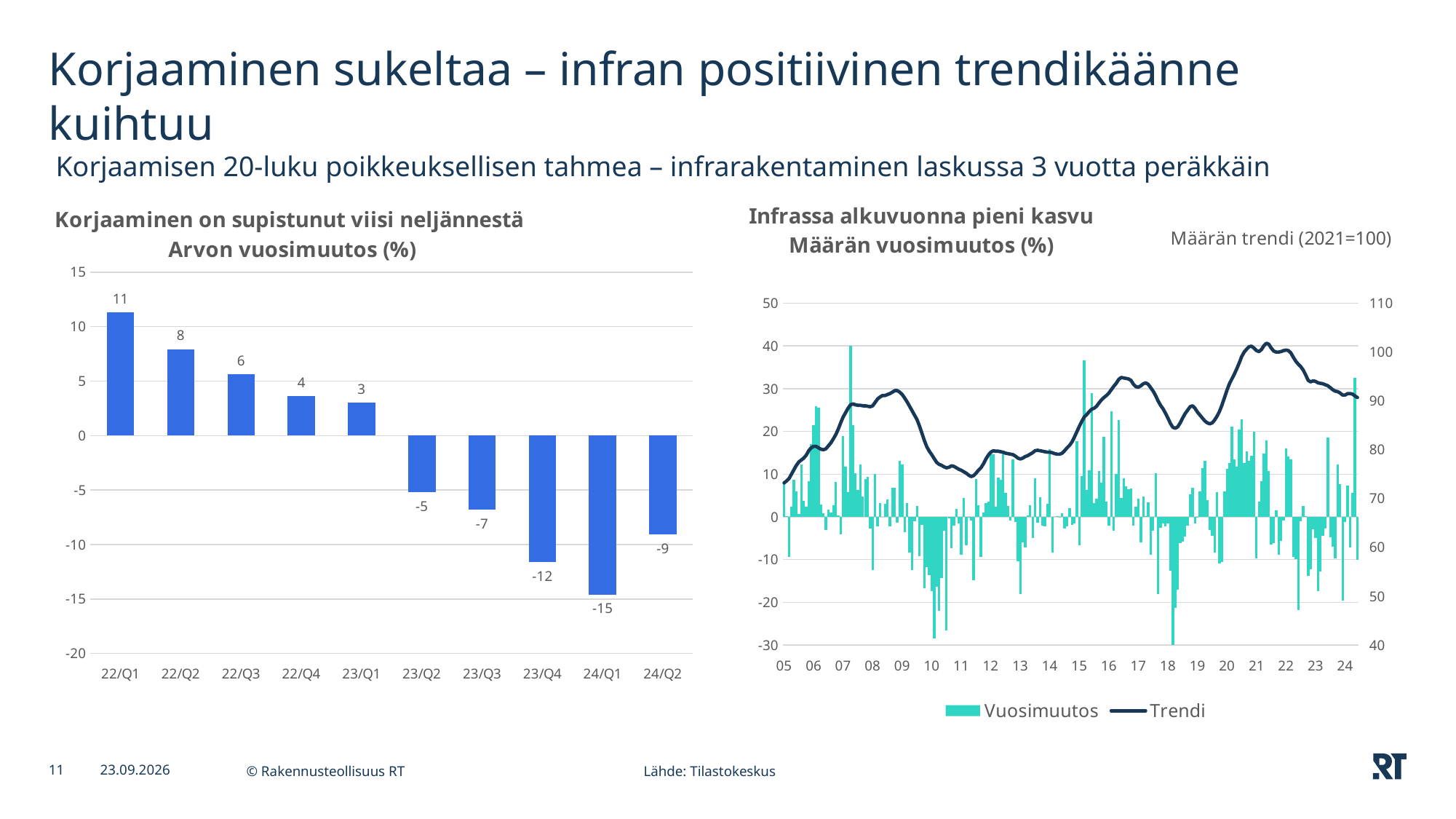
In the left chart 'Korjaaminen on supistunut viisi neljännestä', what is the difference between the values for 22/Q1 and 22/Q2? 3 In the left chart 'Korjaaminen on supistunut viisi neljännestä', which quarter has the highest value? 22/Q1 In the right chart 'Infrassa alkuvuonna pieni kasvu', what are the two legend entries? Vuosimuutos and Trendi In the left chart 'Korjaaminen on supistunut viisi neljännestä', what is the value for 22/Q1? 11 In the right chart 'Infrassa alkuvuonna pieni kasvu', how many series does the legend list? 2 In the left chart 'Korjaaminen on supistunut viisi neljännestä', which quarter has the lowest value? 24/Q1 In the left chart 'Korjaaminen on supistunut viisi neljännestä', which is larger, the value for 23/Q2 or the value for 23/Q3? 23/Q2 In the left chart 'Korjaaminen on supistunut viisi neljännestä', what is the value for 24/Q1? -15 In the left chart 'Korjaaminen on supistunut viisi neljännestä', how many quarters are shown on the x axis? 10 What kind of chart is the left chart 'Korjaaminen on supistunut viisi neljännestä'? bar chart In the left chart 'Korjaaminen on supistunut viisi neljännestä', do the values rise or fall from 22/Q1 to 24/Q1? fall In the left chart 'Korjaaminen on supistunut viisi neljännestä', what is the value for 23/Q4? -12